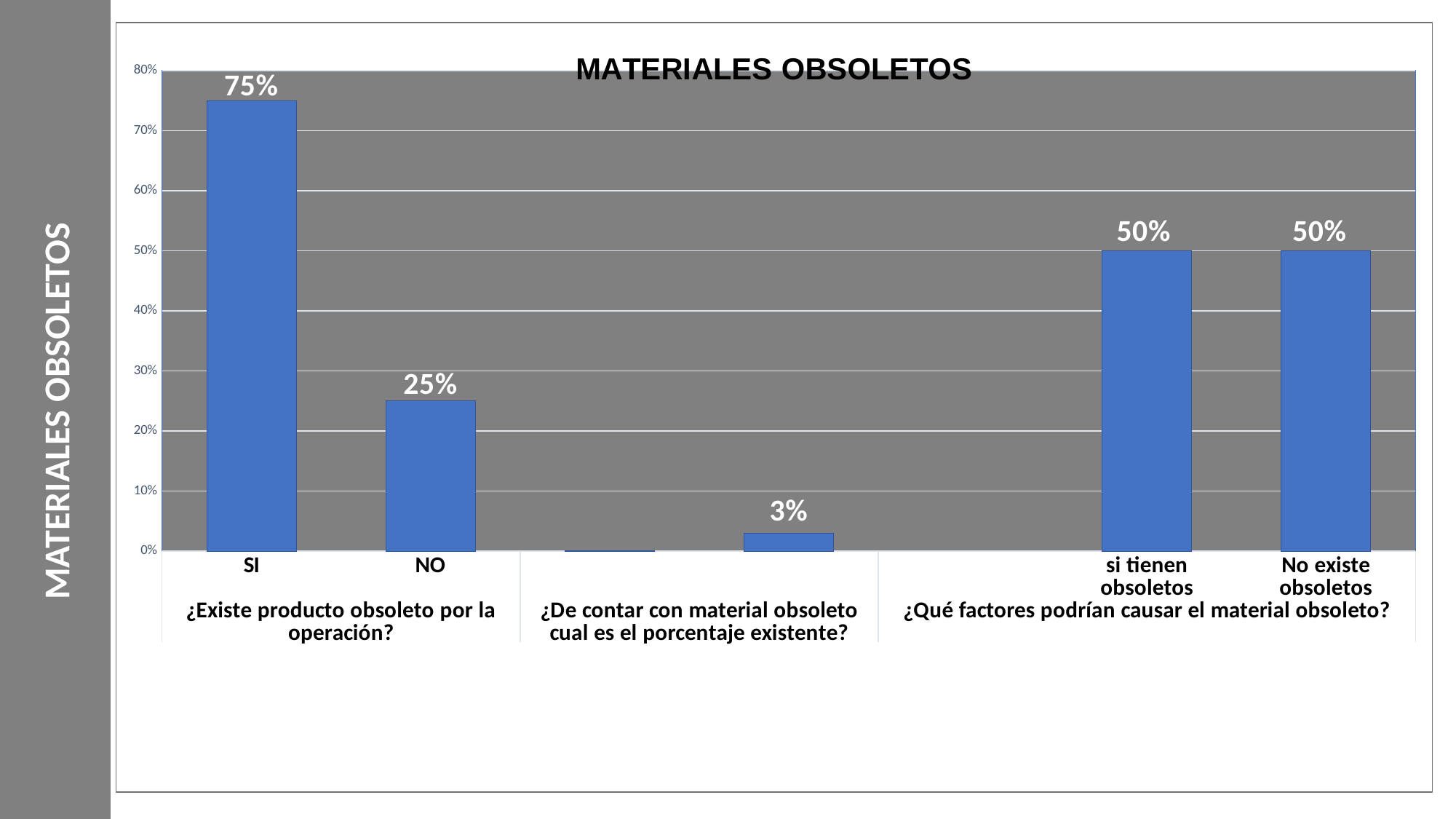
Is the value for NO greater or less than 30%? less Which labeled category has the highest value in the chart? SI Is the value for "si tienen obsoletos" greater or less than 40%? greater What kind of chart is shown on the slide? bar chart What is the difference between the values for SI and NO? 50% What is the value for NO under "¿Existe producto obsoleto por la operación?"? 25% What is the title of the chart? MATERIALES OBSOLETOS How many survey questions are shown as groups along the x axis? 3 What is the value for "si tienen obsoletos" under "¿Qué factores podrían causar el material obsoleto?"? 50% What is the value for SI under "¿Existe producto obsoleto por la operación?"? 75% What is the value for "No existe obsoletos" under "¿Qué factores podrían causar el material obsoleto?"? 50% Which is larger, the value for SI or the value for NO? SI